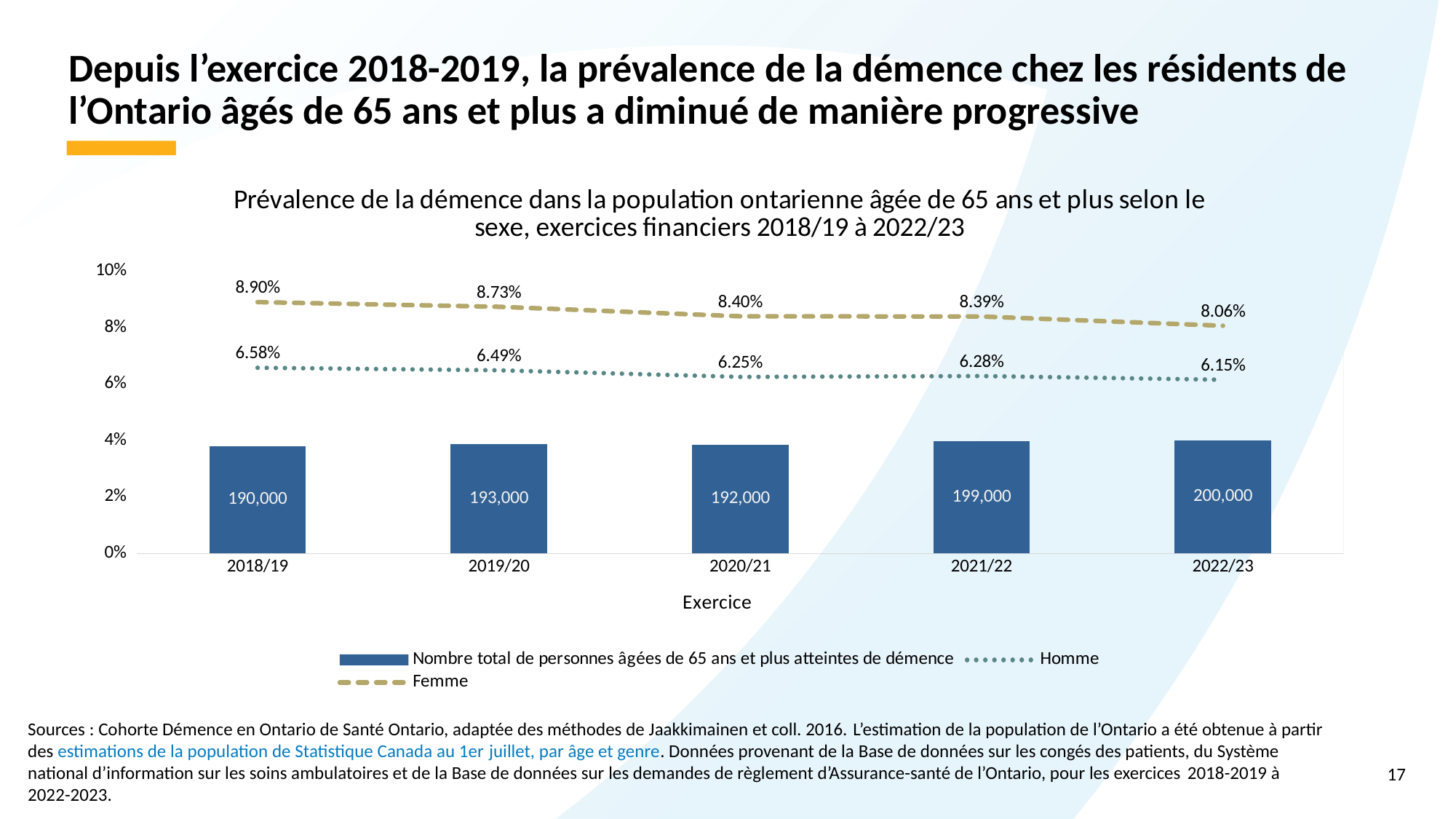
In which fiscal year is the total number of people aged 65 and over with dementia highest? 2022/23 Does the Femme prevalence rise or fall from 2018/19 to 2022/23? Fall In which fiscal year is the Homme prevalence highest? 2018/19 How many series does the legend list? 3 In which fiscal year is the Femme prevalence lowest? 2022/23 What is the dementia prevalence for Homme in 2022/23? 6.15% How many fiscal years are shown on the x axis? 5 Which is larger, the Homme prevalence in 2020/21 or in 2021/22? 2021/22 By how much did the total number of people aged 65 and over with dementia increase from 2018/19 to 2022/23? 10,000 What is the difference between the Femme and Homme prevalence in 2018/19? 2.32 percentage points What is the dementia prevalence for Femme in 2018/19? 8.90% What is the total number of people aged 65 and over with dementia in 2021/22? 199,000